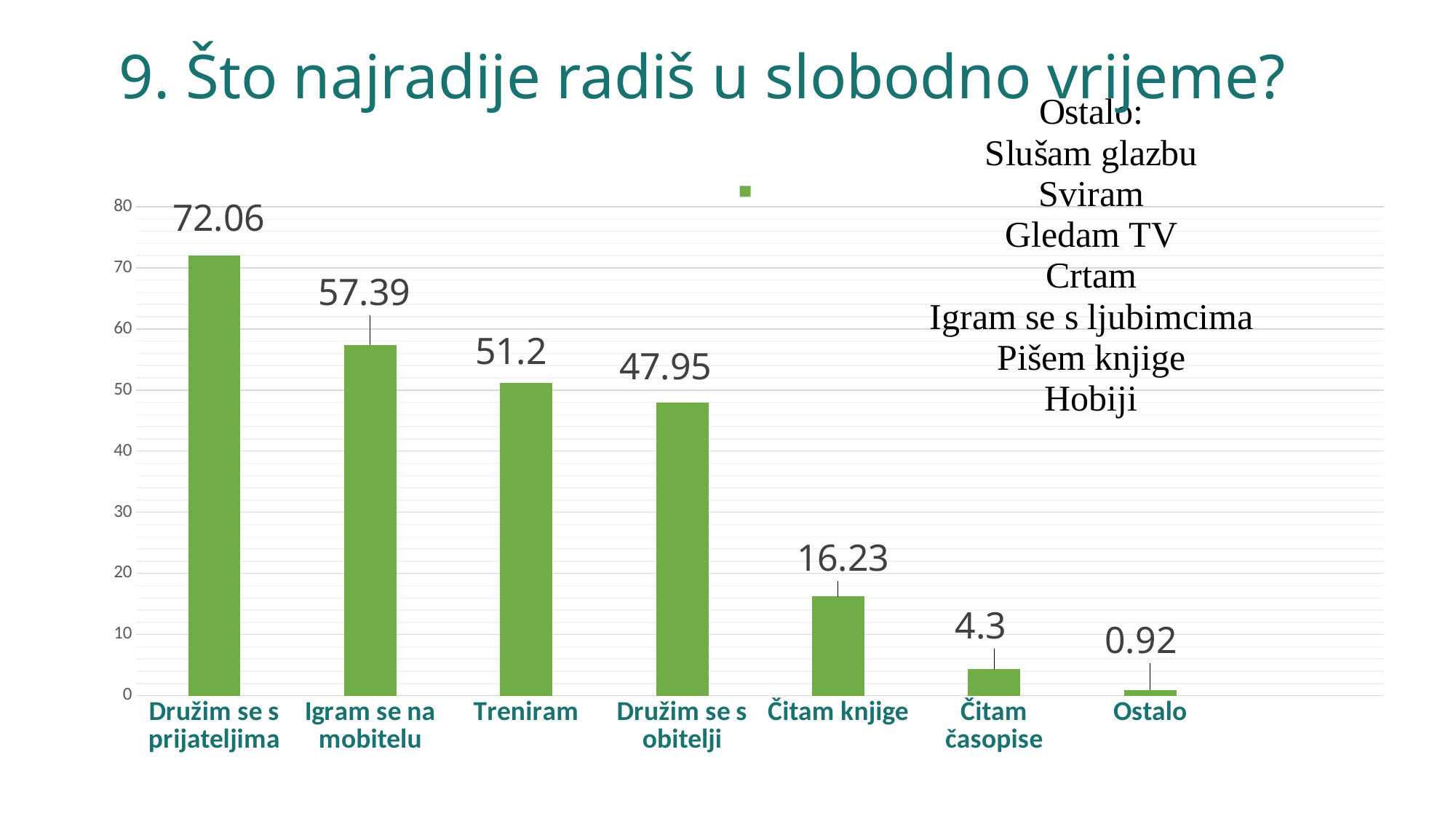
What is the value for "Ostalo"? 0.92 What is the value for "Čitam knjige"? 16.23 What kind of chart is shown on the slide? bar chart What is the difference between the values for "Družim se s prijateljima" and "Igram se na mobitelu"? 14.67 What is the value for "Treniram"? 51.2 Is the value for "Čitam časopise" greater or less than 10? less What is the value for "Igram se na mobitelu"? 57.39 Which category has the lowest value? Ostalo Which is larger, the value for "Treniram" or the value for "Družim se s obitelji"? Treniram How many categories are shown on the x axis? 7 What is the value for "Družim se s prijateljima"? 72.06 Which category has the highest value? Družim se s prijateljima